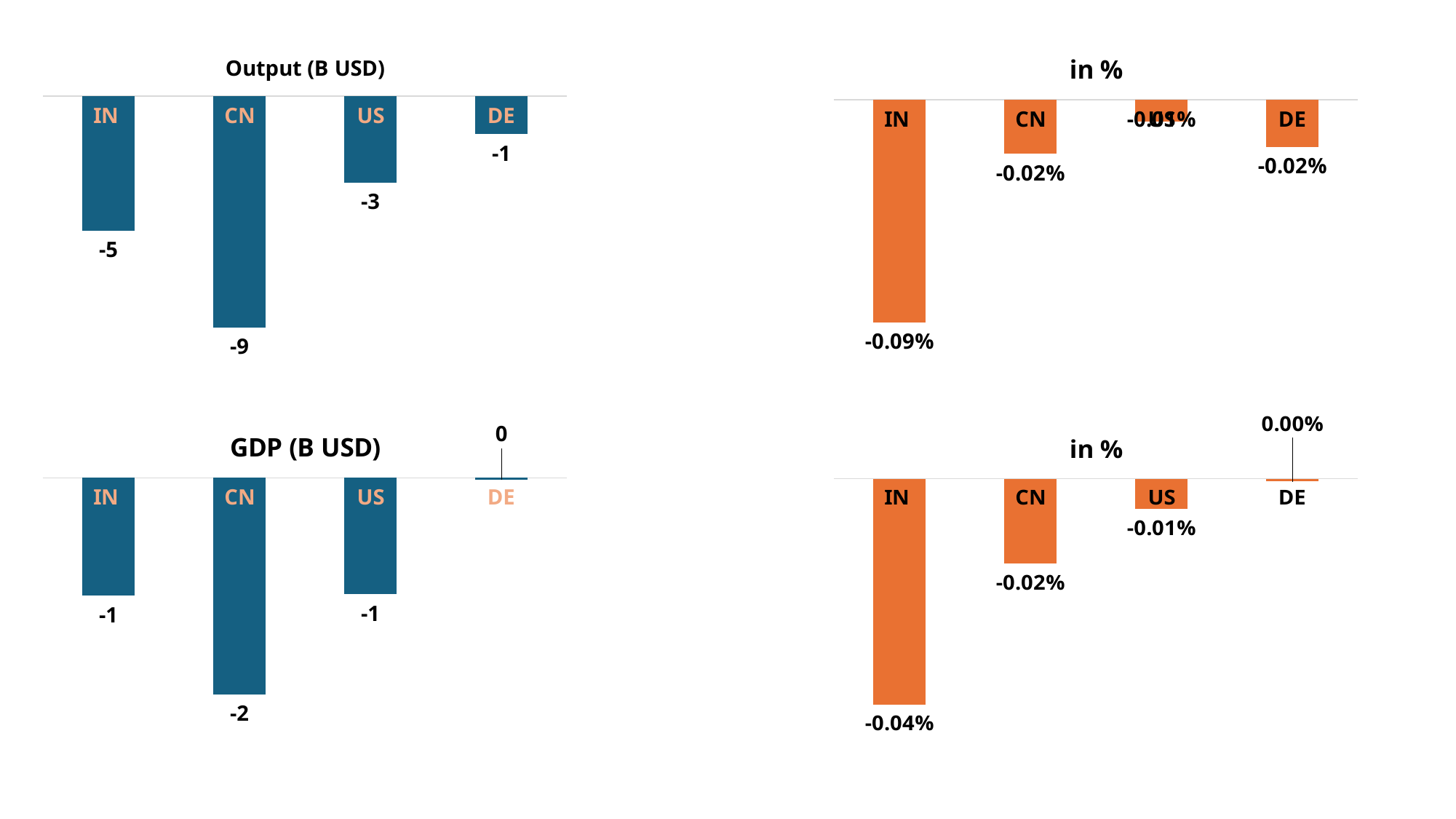
In the top-right chart titled 'in %', what is the value for DE? -0.02% In the Output (B USD) chart, how many categories are shown? 4 In the bottom-right chart titled 'in %', what is the value for US? -0.01% In the top-right chart titled 'in %', what is the value for IN? -0.09% What kind of chart is the bottom-right chart titled 'in %'? bar chart In the GDP (B USD) chart, what is the value for CN? -2 In the Output (B USD) chart, what is the value for CN? -9 In the Output (B USD) chart, what is the difference between the values for IN and US? 2 In the GDP (B USD) chart, what is the value for DE? 0 In the GDP (B USD) chart, which category has the highest value? DE In the Output (B USD) chart, what is the value for IN? -5 In the Output (B USD) chart, which category has the lowest value? CN